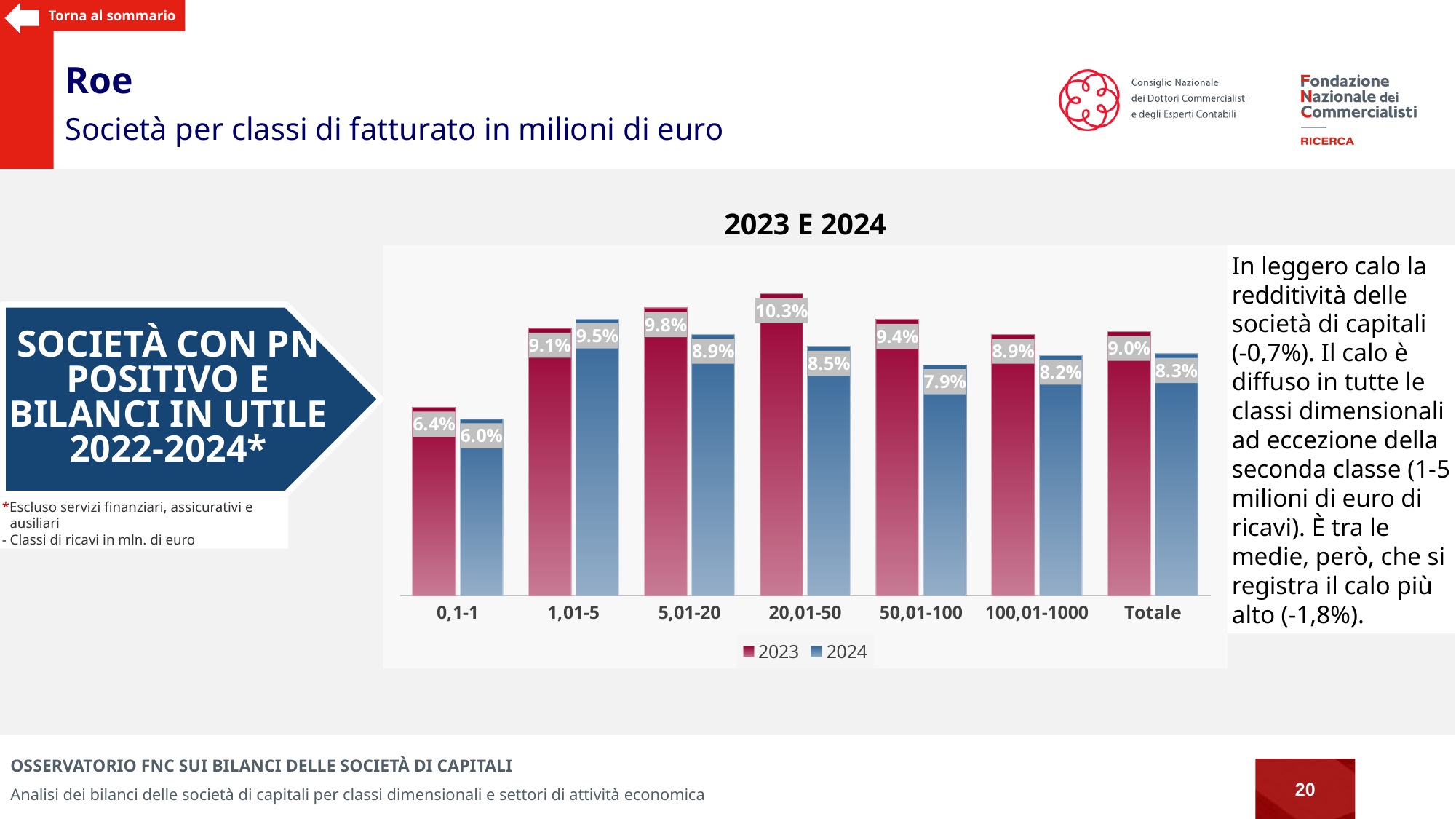
What is the 2023 value for the 20,01-50 class? 10.3% Which is larger for the 1,01-5 class, the 2023 value or the 2024 value? 2024 What is the 2024 value for the 1,01-5 class? 9.5% What is the title of the chart? 2023 E 2024 What is the 2024 value for Totale? 8.3% How many series does the legend list? 2 What kind of chart is shown? Bar chart Which colour represents the 2024 series? Blue Which class has the highest 2023 value? 20,01-50 What is the difference between the 2023 and 2024 values for the 50,01-100 class? 1.5% Which class has the lowest 2024 value? 0,1-1 How many categories are shown on the x axis? 7